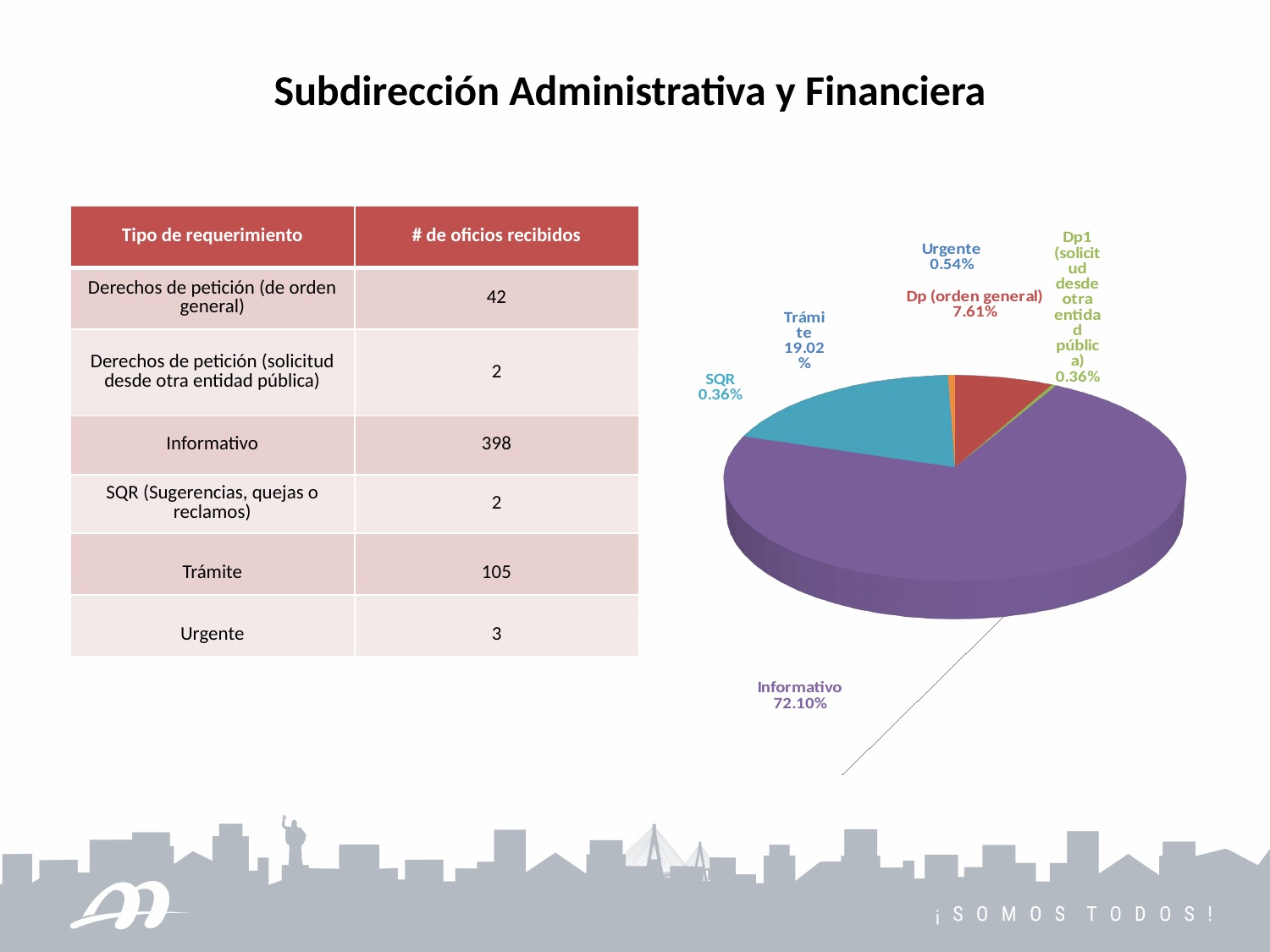
What colour is the Informativo slice in the pie chart? purple Which category has the largest slice in the pie chart? Informativo What percentage is shown for Urgente in the pie chart? 0.54% How many slices does the pie chart have? 6 What percentage does the Informativo slice represent in the pie chart? 72.10% What percentage is shown for Dp (orden general) in the pie chart? 7.61% Which slice is larger in the pie chart, Urgente or SQR? Urgente What percentage is shown for Trámite in the pie chart? 19.02% What is the difference in percentage points between the Informativo and Trámite slices? 53.08% What type of chart is shown on the slide? pie chart Which slice is larger in the pie chart, Trámite or Dp (orden general)? Trámite What percentage is shown for SQR in the pie chart? 0.36%